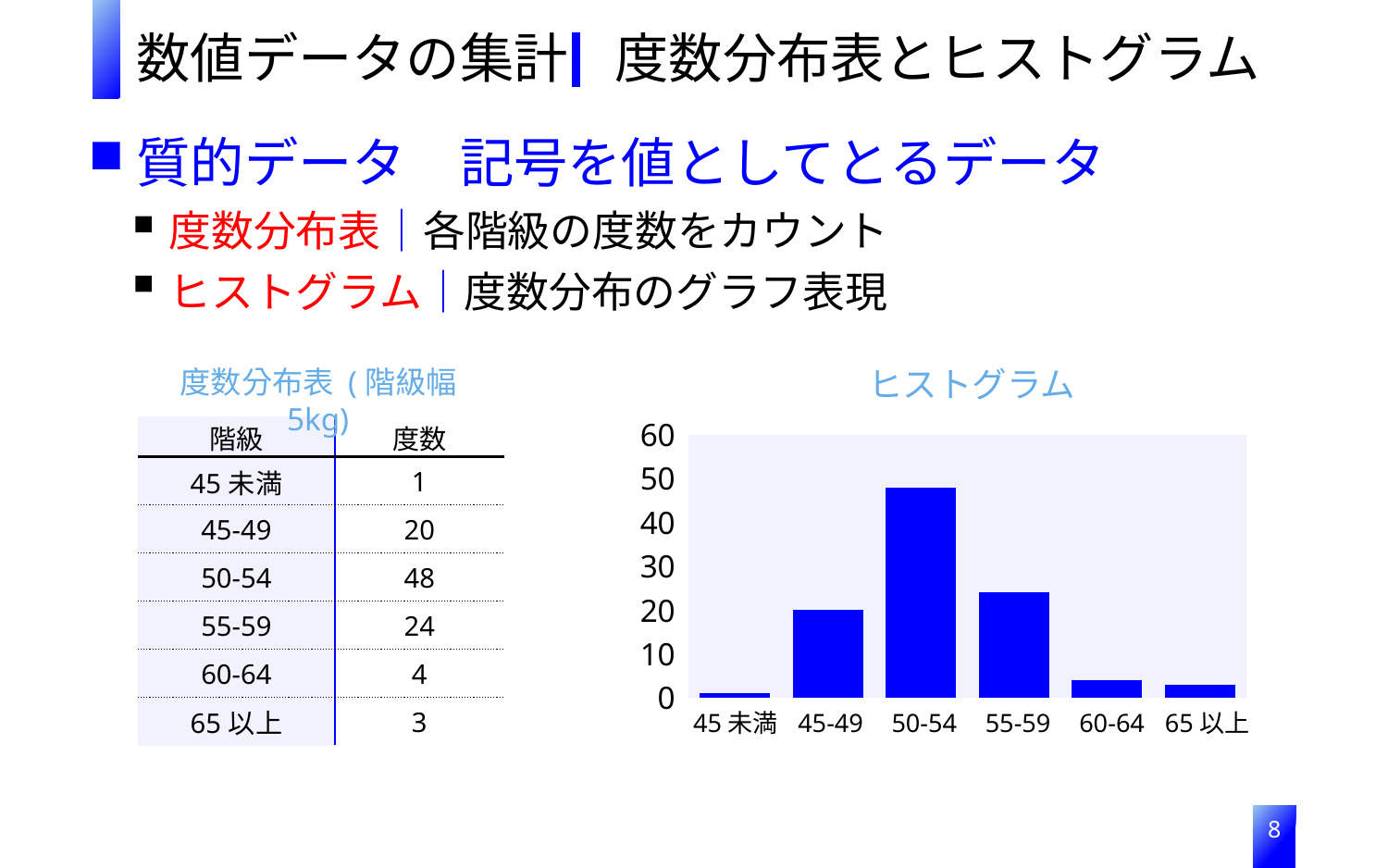
Which category has the lowest bar in the ヒストグラム chart? 45 未満 According to the frequency table on the slide, what is the frequency (度数) for the 65 以上 class? 3 Is the bar for 50-54 in the ヒストグラム chart greater or less than 40? greater In the ヒストグラム chart, which bar is taller, 45-49 or 55-59? 55-59 According to the frequency table on the slide, what is the frequency (度数) for the 55-59 class? 24 What kind of chart is the ヒストグラム chart? bar chart According to the frequency table on the slide, what is the frequency (度数) for the 50-54 class? 48 How many categories are shown on the x axis of the ヒストグラム chart? 6 Is the bar for 60-64 in the ヒストグラム chart greater or less than 10? less What is the title of the bar chart on the right of the slide? ヒストグラム Which category has the highest bar in the ヒストグラム chart? 50-54 Using the frequencies in the table, what is the difference between the 50-54 and 45-49 frequencies? 28